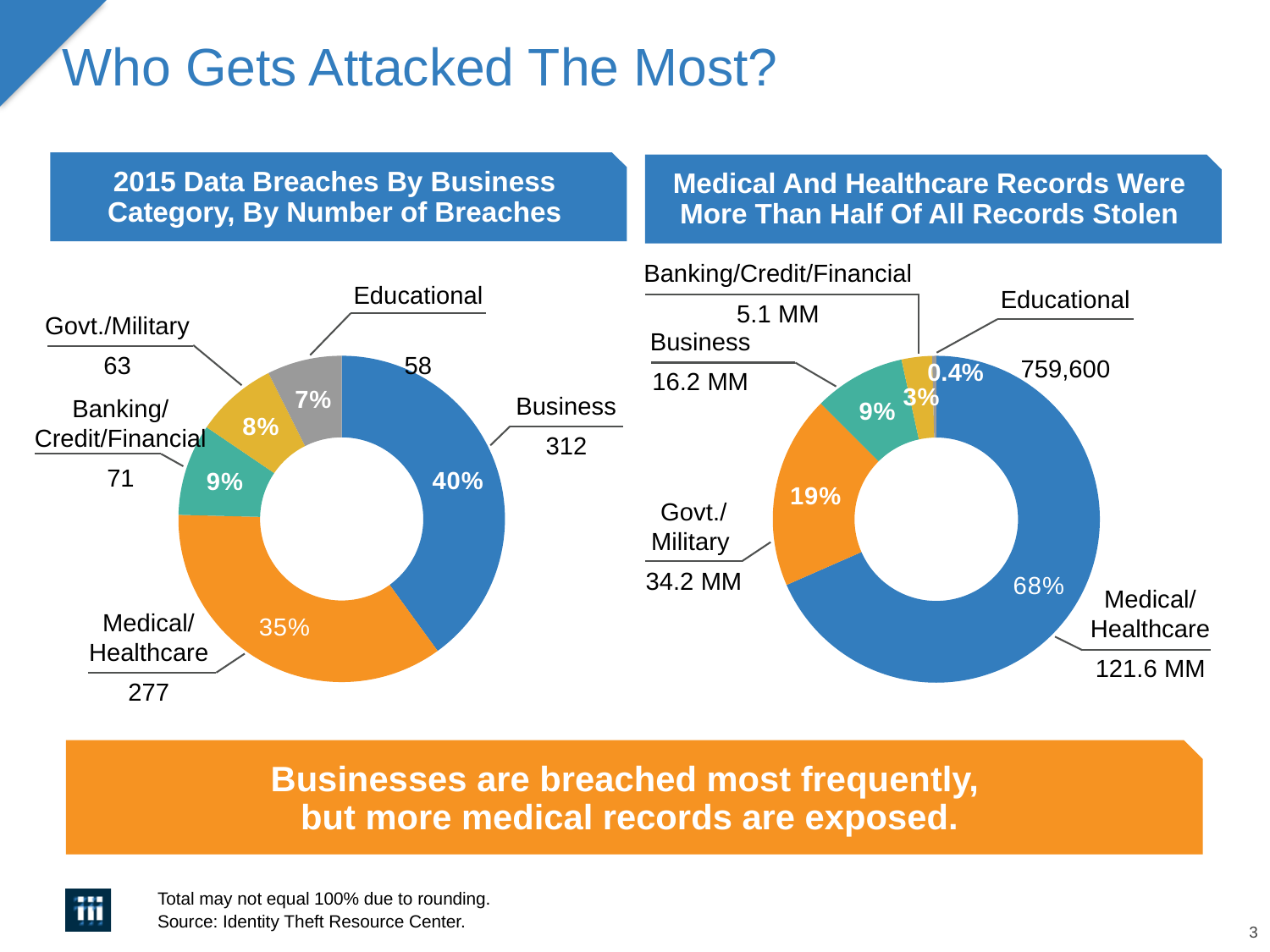
In the left chart (2015 Data Breaches By Business Category), how many breaches were in the Business category? 312 In the right chart (Medical And Healthcare Records Were More Than Half Of All Records Stolen), which is larger: records stolen from Business or from Banking/Credit/Financial? Business In the left chart (2015 Data Breaches By Business Category), which category has the fewest breaches? Educational In the right chart (Medical And Healthcare Records Were More Than Half Of All Records Stolen), what share of records stolen does Govt./Military represent? 19% In the right chart (Medical And Healthcare Records Were More Than Half Of All Records Stolen), how many records were stolen from Educational? 759,600 In the left chart (2015 Data Breaches By Business Category), how many breaches were in the Medical/Healthcare category? 277 In the left chart (2015 Data Breaches By Business Category), what share of breaches does Govt./Military account for? 8% In the left chart (2015 Data Breaches By Business Category), what is the difference in number of breaches between Business and Medical/Healthcare? 35 In the left chart (2015 Data Breaches By Business Category), how many categories are shown? 5 In the right chart (Medical And Healthcare Records Were More Than Half Of All Records Stolen), which category has the smallest share of records stolen? Educational What kind of chart is used on the right (Medical And Healthcare Records Were More Than Half Of All Records Stolen)? Donut (pie) chart In the right chart (Medical And Healthcare Records Were More Than Half Of All Records Stolen), how many records were stolen from Medical/Healthcare? 121.6 MM